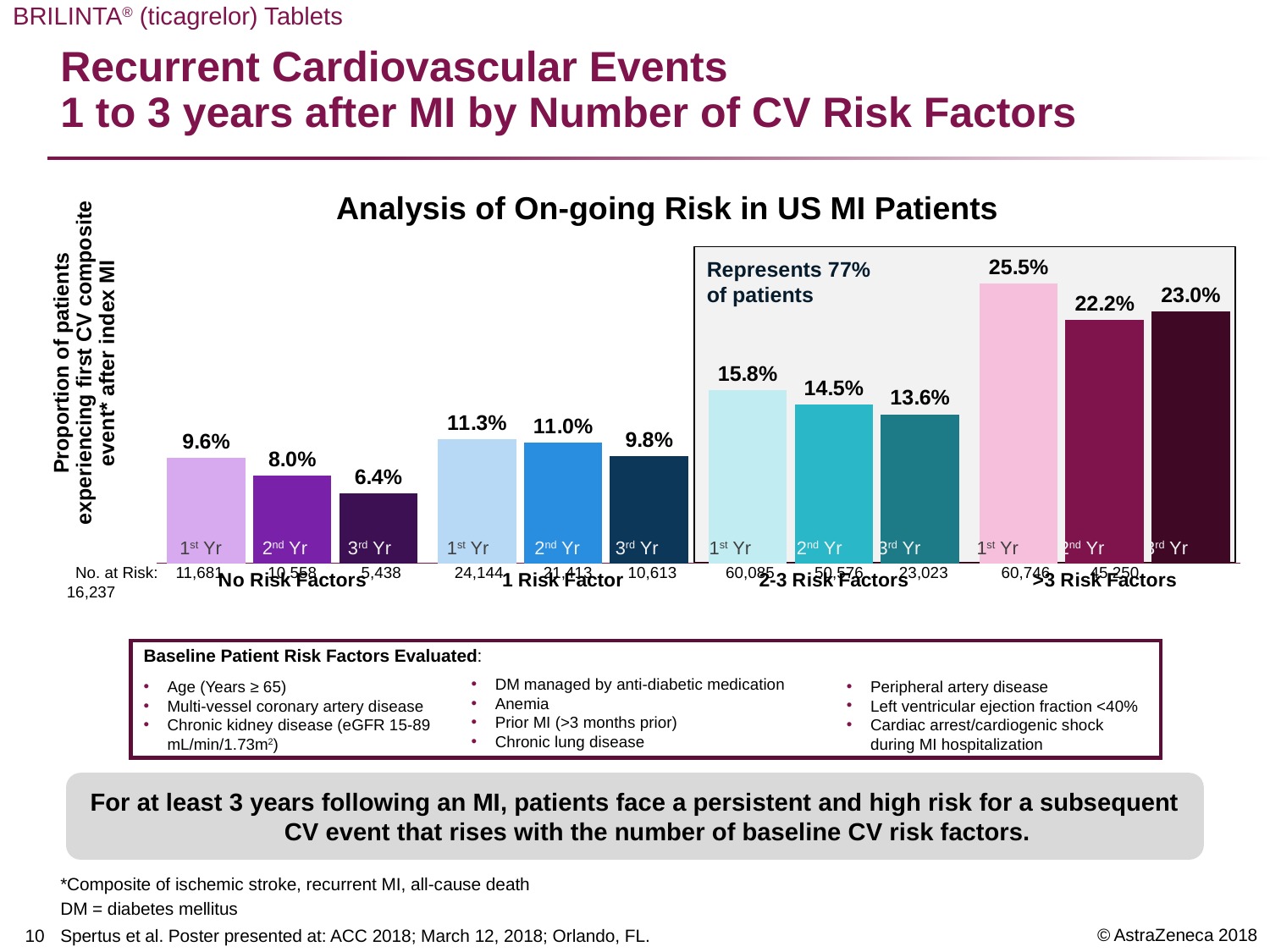
Which bar has the lowest value on the chart? 3rd Yr, No Risk Factors (6.4%) How many bars are plotted on the chart in total? 12 Within the No Risk Factors group, do the values rise or fall from 1st Yr to 3rd Yr? Fall What is the value for the 2nd Yr bar in the >3 Risk Factors group? 22.2% How many risk-factor groups are shown on the x axis? 4 What is the difference between the 1st Yr values of the >3 Risk Factors group and the 2-3 Risk Factors group? 9.7% What is the difference between the 1st Yr and 3rd Yr values in the 1 Risk Factor group? 1.5% What is the value for the 3rd Yr bar in the 2-3 Risk Factors group? 13.6% What kind of chart is shown on the slide? Bar chart Which bar has the highest value on the chart? 1st Yr, >3 Risk Factors (25.5%) Which is larger: the 2nd Yr value in the >3 Risk Factors group or the 3rd Yr value in the same group? 3rd Yr (23.0%) What is the value for the 1st Yr bar in the No Risk Factors group? 9.6%